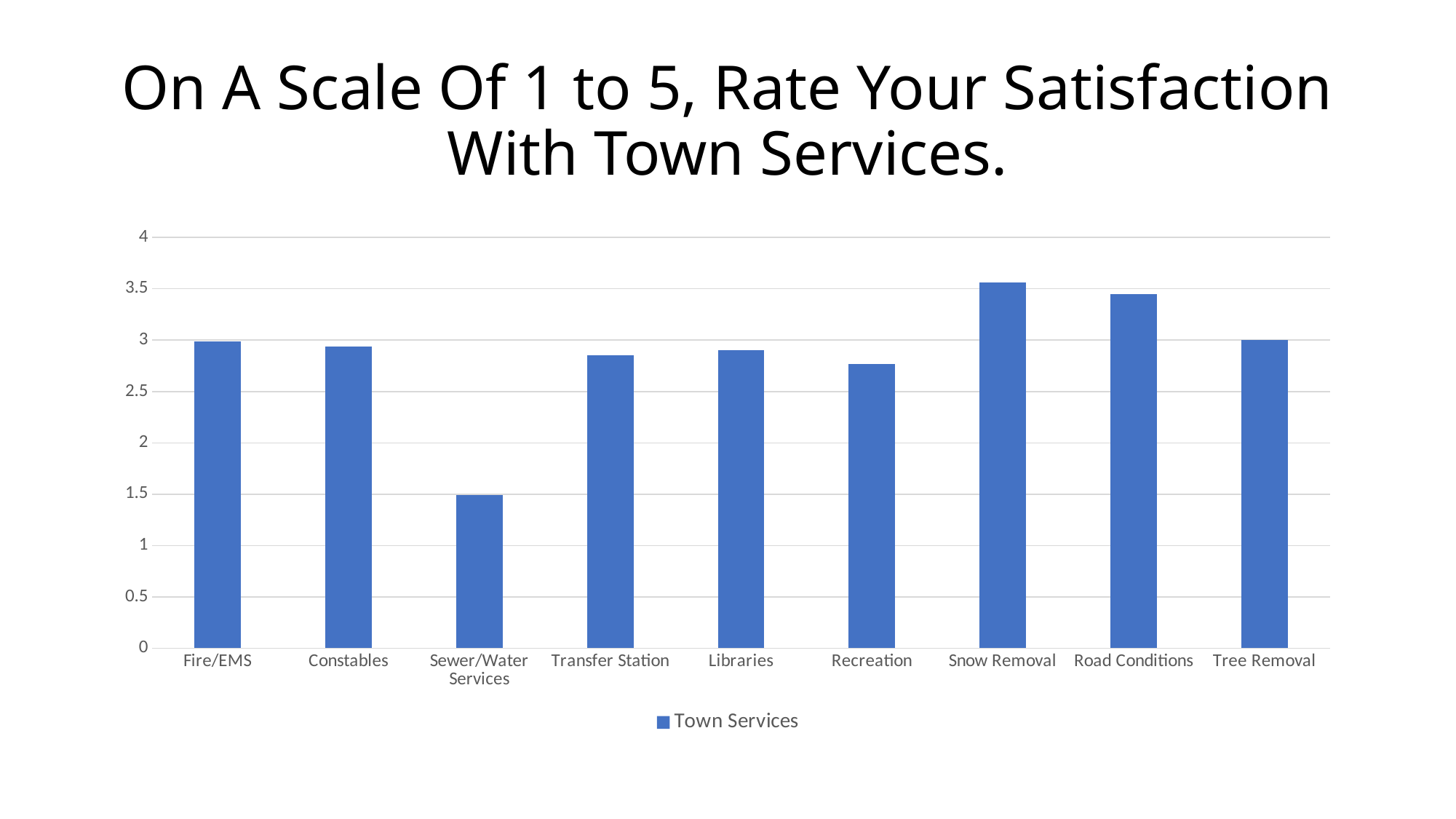
Is the value for Recreation greater or less than 3? less Which has a higher satisfaction rating, Sewer/Water Services or Transfer Station? Transfer Station Is the value for Snow Removal greater or less than 3.5? greater Which town service has the lowest satisfaction rating? Sewer/Water Services How many town services are shown on the x axis? 9 Which town service has the highest satisfaction rating? Snow Removal What is the name of the series shown in the legend? Town Services Is the value for Sewer/Water Services greater or less than 2? less How many series does the legend list? 1 Which has a higher satisfaction rating, Road Conditions or Recreation? Road Conditions What kind of chart is shown on the slide? bar chart